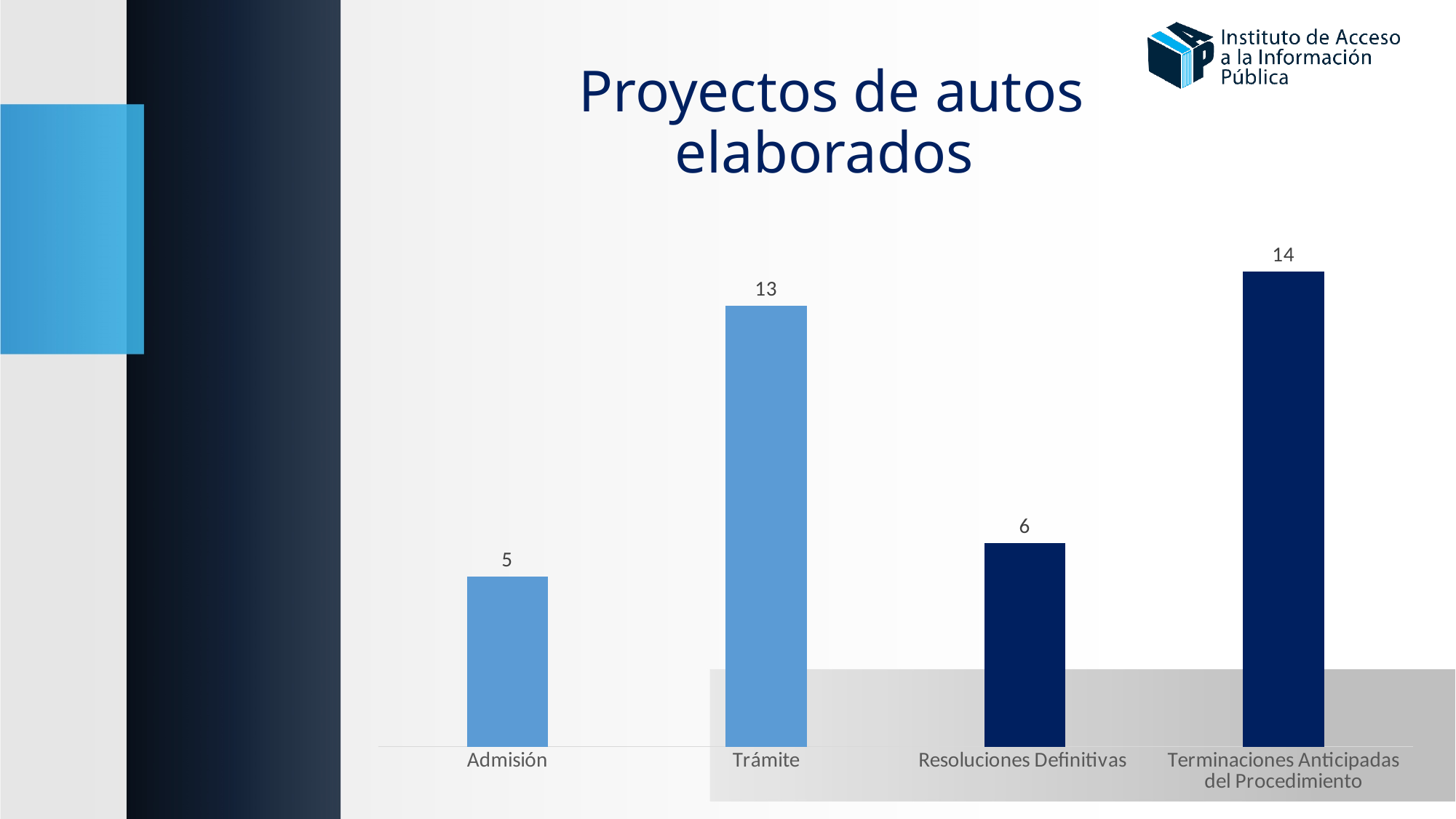
What kind of chart is shown on the slide? Bar chart What is the value for Trámite? 13 What is the difference between the values for Trámite and Admisión? 8 What is the value for Terminaciones Anticipadas del Procedimiento? 14 Which category has the highest value? Terminaciones Anticipadas del Procedimiento What is the difference between the values for Terminaciones Anticipadas del Procedimiento and Resoluciones Definitivas? 8 What is the value for Admisión? 5 What is the title of the slide? Proyectos de autos elaborados What is the value for Resoluciones Definitivas? 6 How many categories are shown in the chart? 4 Which category has the lowest value? Admisión Which is larger, the value for Trámite or the value for Resoluciones Definitivas? Trámite